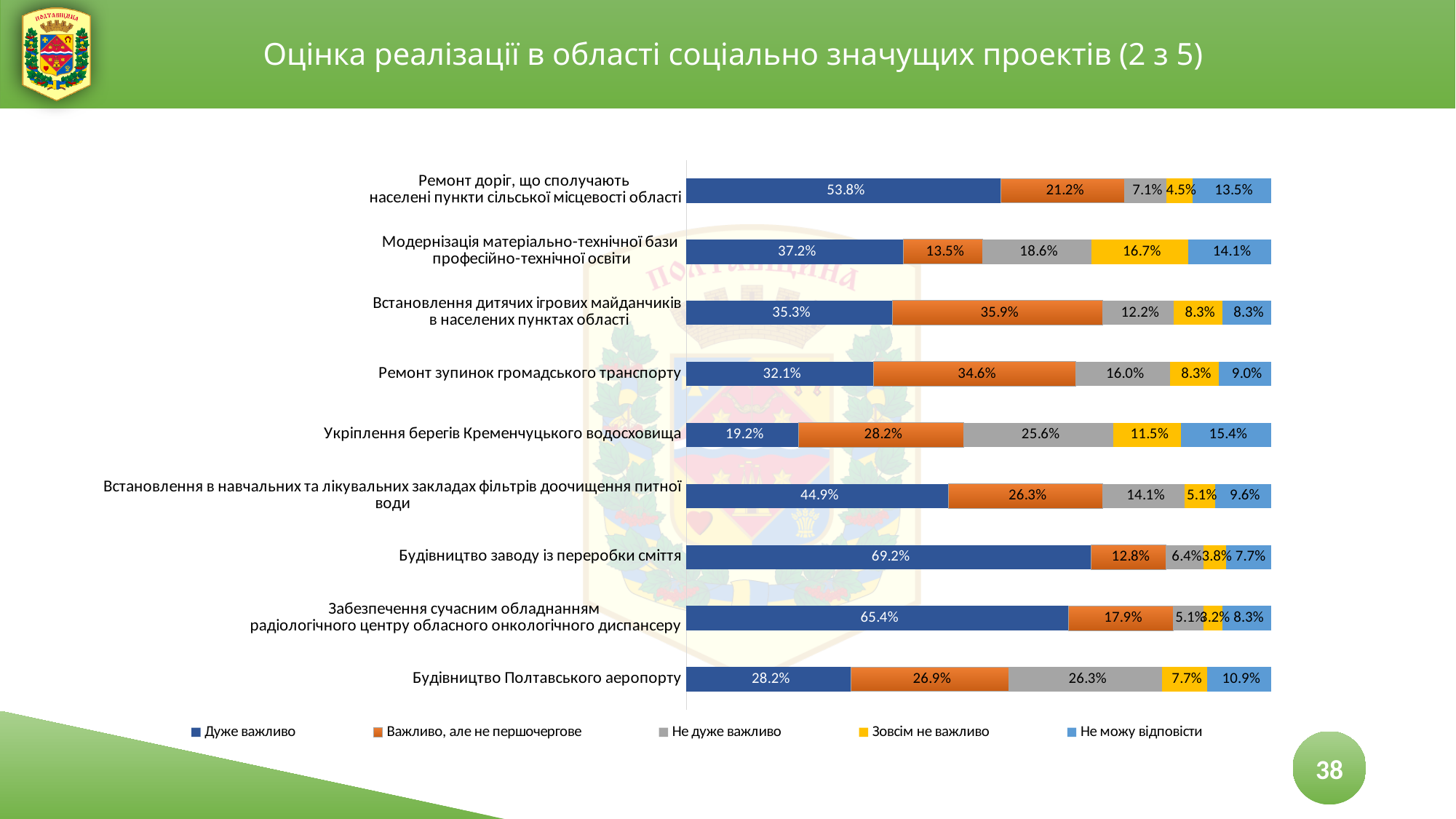
What is the 'Не можу відповісти' value for 'Укріплення берегів Кременчуцького водосховища'? 15.4% How many project categories are plotted on the chart? 9 What is the difference in 'Дуже важливо' share between 'Будівництво заводу із переробки сміття' and 'Забезпечення сучасним обладнанням радіологічного центру обласного онкологічного диспансеру'? 3.8 percentage points What is the title of the slide? Оцінка реалізації в області соціально значущих проектів (2 з 5) What is the 'Дуже важливо' value for 'Будівництво заводу із переробки сміття'? 69.2% Which project has the lowest 'Дуже важливо' share? Укріплення берегів Кременчуцького водосховища Which has the larger 'Не дуже важливо' share: 'Модернізація матеріально-технічної бази професійно-технічної освіти' or 'Ремонт зупинок громадського транспорту'? Модернізація матеріально-технічної бази професійно-технічної освіти How many series does the legend list? 5 Which project has the highest 'Дуже важливо' share? Будівництво заводу із переробки сміття What is the 'Зовсім не важливо' value for 'Модернізація матеріально-технічної бази професійно-технічної освіти'? 16.7% Which project has the highest 'Зовсім не важливо' share? Модернізація матеріально-технічної бази професійно-технічної освіти What type of chart is shown on the slide? Stacked bar chart